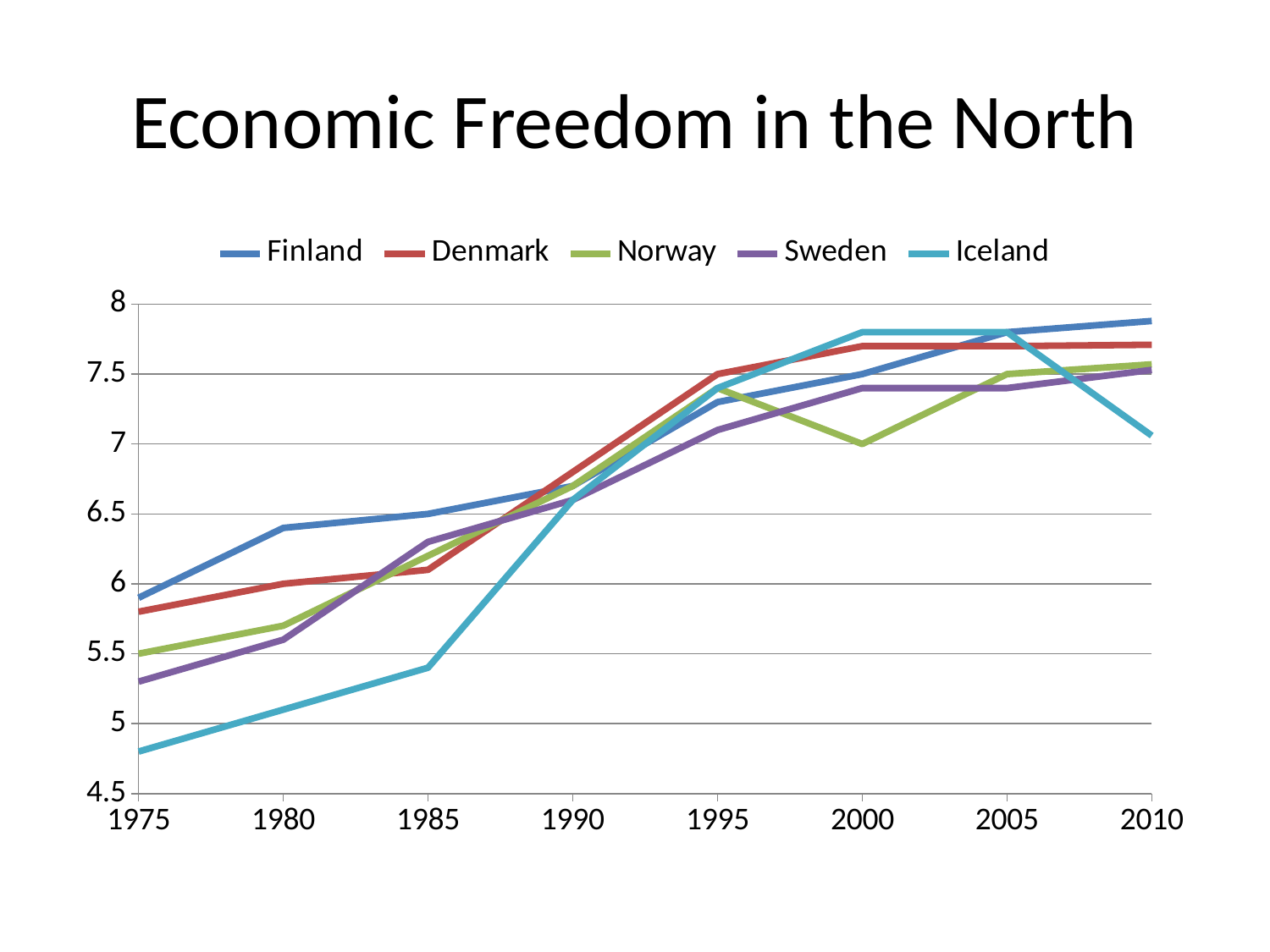
Which country has the lowest value in 1975? Iceland How many series does the legend list? 5 Is the value for Sweden in 1975 greater or less than 5.5? less Which is larger in 2000, the value for Sweden or the value for Norway? Sweden Which country has the highest value in 2010? Finland How many years are marked along the x axis? 8 Does the Iceland line rise or fall between 2005 and 2010? fall What kind of chart is shown on the slide? line chart Which country has the highest value in 1975? Finland Which country has the lowest value in 2000? Norway Is the value for Finland in 2010 greater or less than 7.5? greater Is the value for Iceland in 1975 greater or less than 5? less